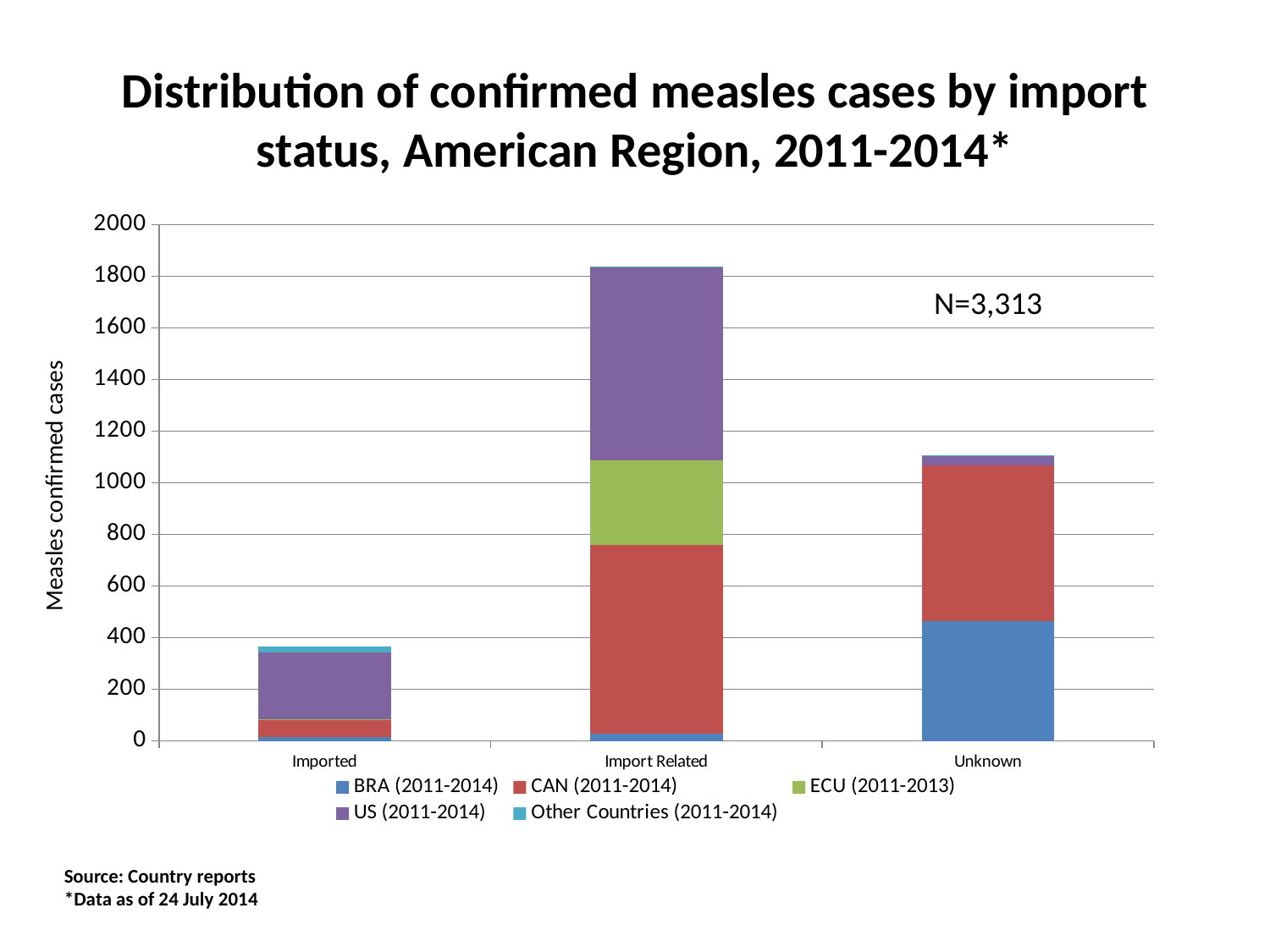
Which import status category has the lowest total number of confirmed measles cases? Imported Which has more confirmed measles cases in total, Import Related or Unknown? Import Related Is the total number of cases for Import Related greater or less than 1600? greater Which import status category has the highest total number of confirmed measles cases? Import Related What total N is printed on the chart? N=3,313 Which has more confirmed measles cases in total, Unknown or Imported? Unknown What is the label of the y axis? Measles confirmed cases Is the total number of cases for Imported greater or less than 400? less How many import status categories are shown on the x axis? 3 Is the total number of cases for Unknown greater or less than 1000? greater How many series does the legend list? 5 What kind of chart is shown on the slide? Stacked bar chart